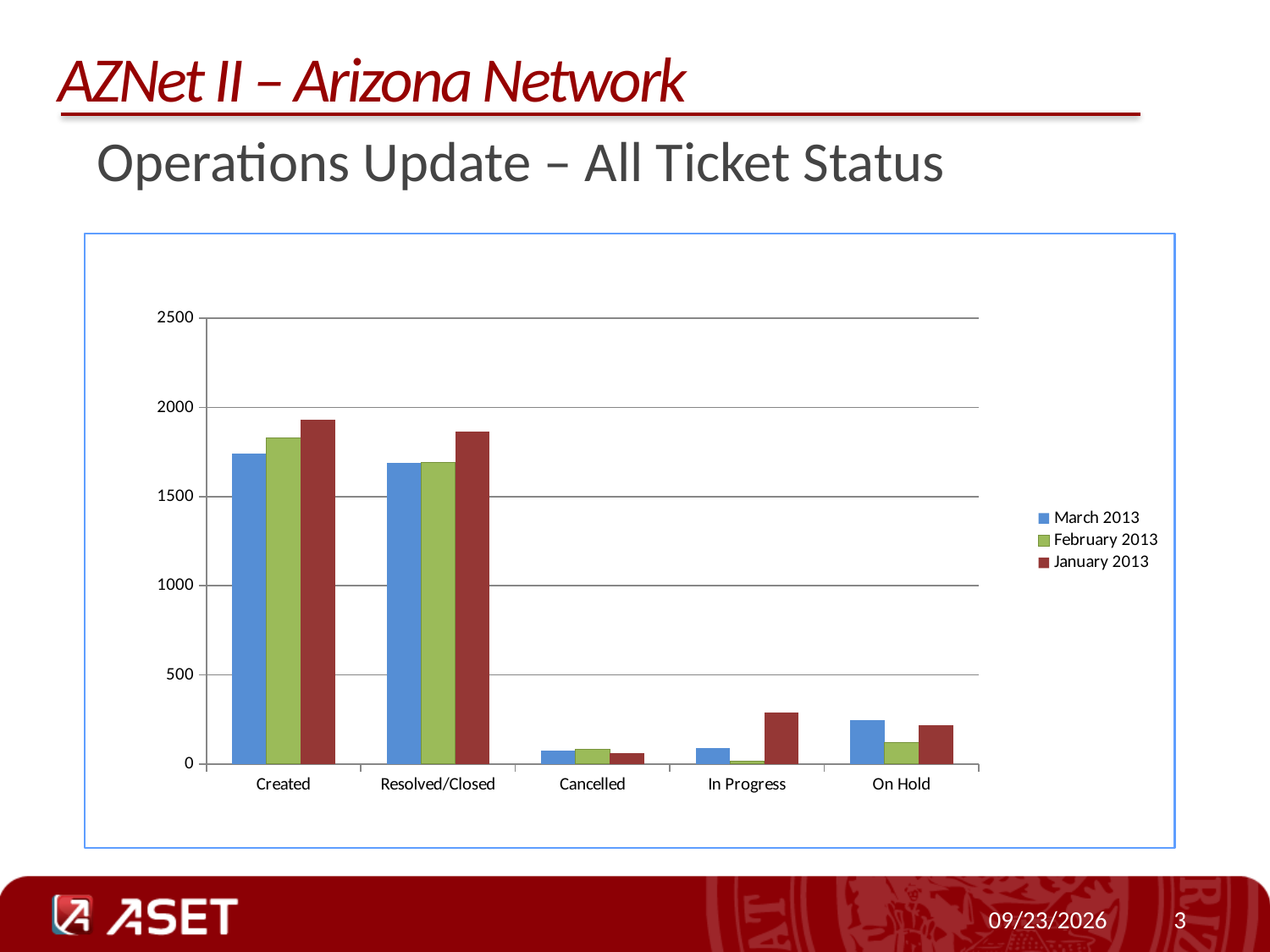
For On Hold, which is larger: the March 2013 value or the February 2013 value? March 2013 How many ticket status categories are shown on the x axis? 5 Is the January 2013 value for In Progress greater or less than 500? less Which category has the highest January 2013 value? Created Which category has the lowest February 2013 value? In Progress How many series does the legend list? 3 Is the March 2013 value for Created greater or less than 1500? greater What kind of chart is shown on the slide? bar chart What are the three series listed in the legend? March 2013, February 2013, January 2013 For In Progress, which is larger: the January 2013 value or the February 2013 value? January 2013 For Created, which is larger: the January 2013 value or the March 2013 value? January 2013 Is the January 2013 value for Resolved/Closed greater or less than 2000? less